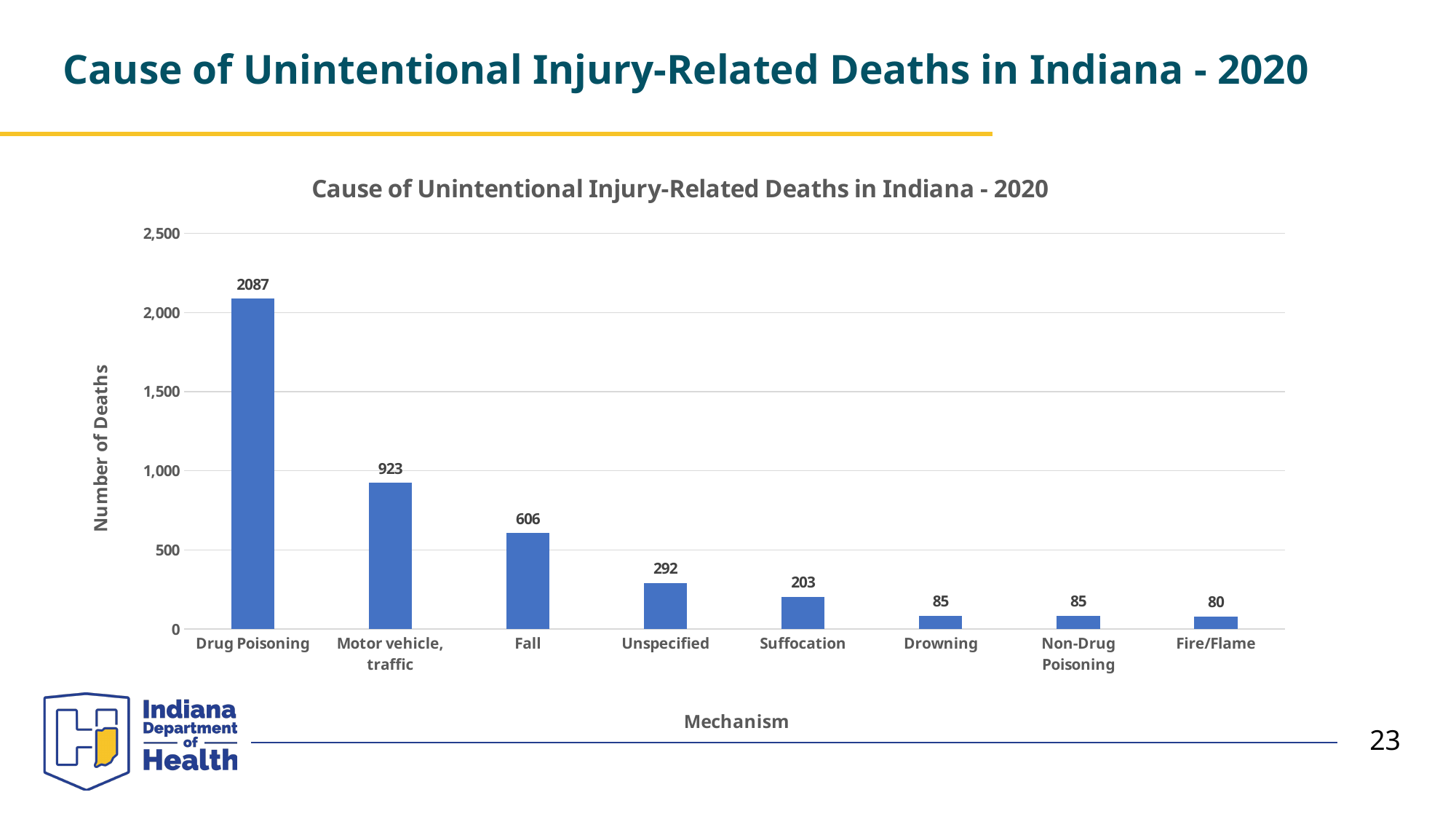
How many mechanisms are shown on the x axis? 8 Which has more deaths, Fall or Unspecified? Fall What is the difference in deaths between Drug Poisoning and Motor vehicle, traffic? 1164 Is the value for Fall greater or less than 500? greater What is the number of deaths for Motor vehicle, traffic? 923 How many deaths are shown for Drug Poisoning? 2087 What kind of chart is shown on the slide? Bar chart What is the value for Suffocation? 203 What is the difference in deaths between Fall and Unspecified? 314 Which mechanism has the lowest number of deaths? Fire/Flame What is the label of the y axis? Number of Deaths Which mechanism has the highest number of deaths? Drug Poisoning